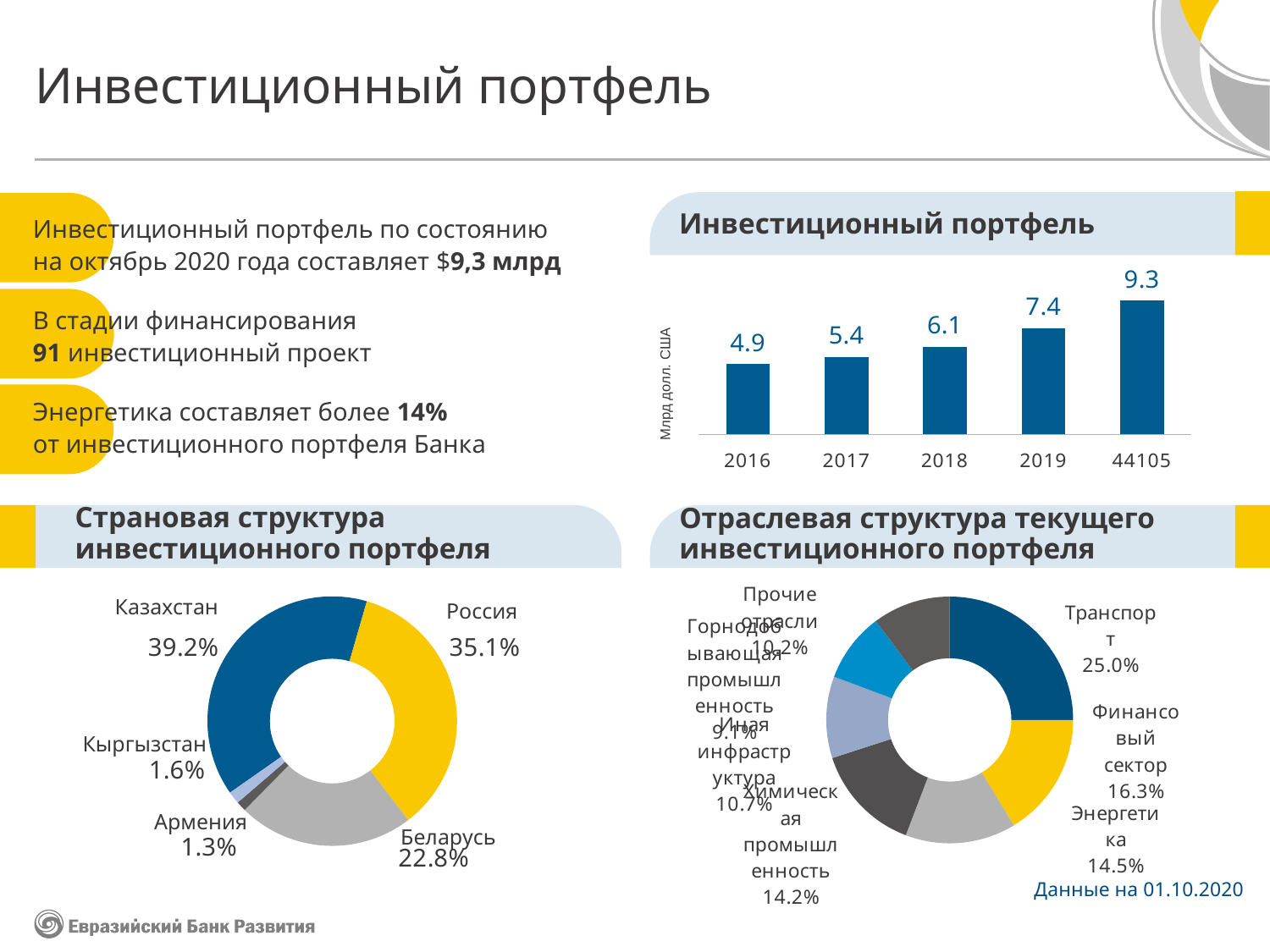
In the 'Страновая структура инвестиционного портфеля' chart, which country has the largest share? Казахстан In the 'Инвестиционный портфель' bar chart, do the values rise or fall from 2016 to the last bar? rise In the 'Инвестиционный портфель' bar chart, which year has the lowest value? 2016 In the 'Инвестиционный портфель' bar chart, what is the value for 2016? 4.9 In the 'Страновая структура инвестиционного портфеля' chart, which is larger: Кыргызстан or Армения? Кыргызстан What type of chart is 'Инвестиционный портфель'? bar chart In the 'Страновая структура инвестиционного портфеля' chart, what is the share for Беларусь? 22.8% In the 'Отраслевая структура текущего инвестиционного портфеля' chart, which sector has the largest share? Транспорт How many bars are in the 'Инвестиционный портфель' chart? 5 In the 'Инвестиционный портфель' bar chart, what is the difference between the 2019 value and the 2017 value? 2.0 In the 'Отраслевая структура текущего инвестиционного портфеля' chart, what is the share for Энергетика? 14.5% In the 'Инвестиционный портфель' bar chart, what is the value for 2018? 6.1